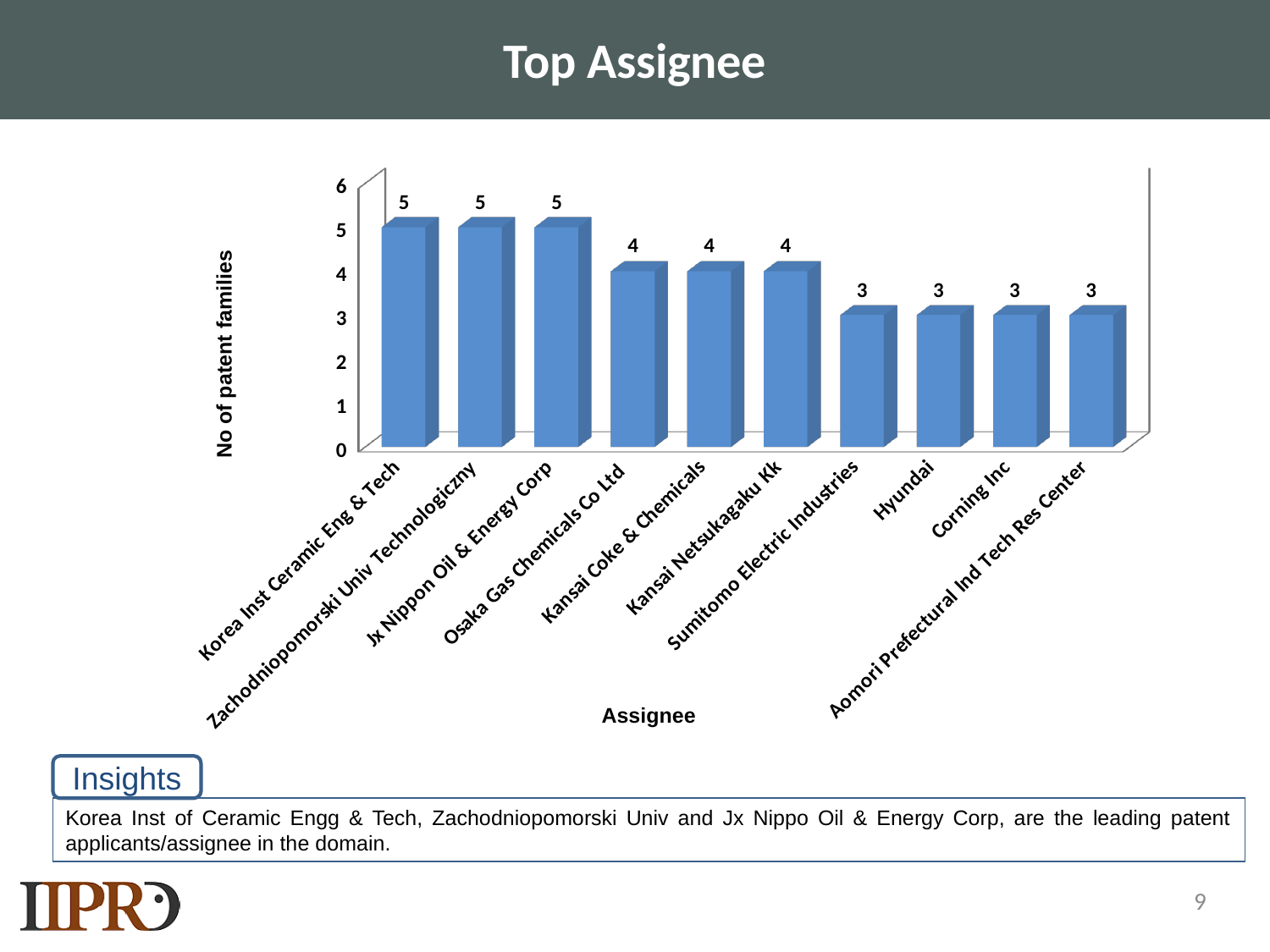
How many patent families does Osaka Gas Chemicals Co Ltd have? 4 What is the value for Hyundai? 3 What kind of chart is shown on the slide? Bar chart What is the label of the y axis? No of patent families Which is larger, the value for Sumitomo Electric Industries or the value for Osaka Gas Chemicals Co Ltd? Osaka Gas Chemicals Co Ltd How many patent families does Korea Inst Ceramic Eng & Tech have? 5 Which assignee has the fewest patent families among the first six bars: Jx Nippon Oil & Energy Corp or Kansai Coke & Chemicals? Kansai Coke & Chemicals What is the value for Kansai Netsukagaku Kk? 4 How many assignees are shown on the chart? 10 Do the values rise or fall from left to right along the x axis? Fall What is the label of the x axis? Assignee What is the difference between the value for Zachodniopomorski Univ Technologiczny and the value for Corning Inc? 2